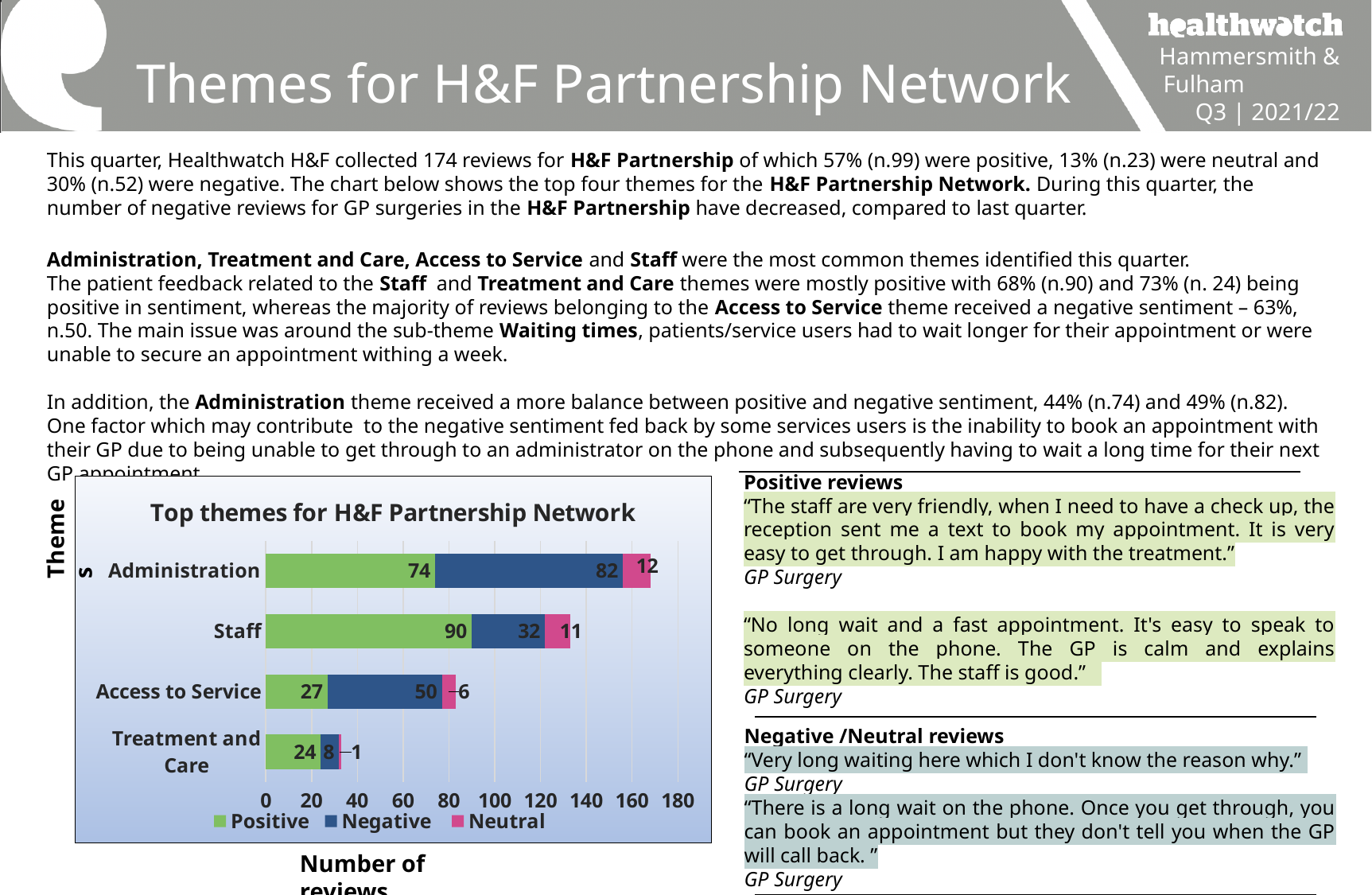
What is the Negative value for Access to Service? 50 What type of chart is shown on the slide? Stacked bar chart What is the difference between the Positive and Negative values for Access to Service? 23 What is the total number of reviews in the Administration bar? 168 Which theme has the highest Negative value? Administration Which is larger for Staff: the Positive value or the Negative value? Positive How many themes (categories) are plotted in the chart? 4 Which theme has the lowest Positive value? Treatment and Care What is the title of the chart? Top themes for H&F Partnership Network What is the Neutral value for Administration? 12 How many series does the chart legend list? 3 What is the Positive value for Staff? 90